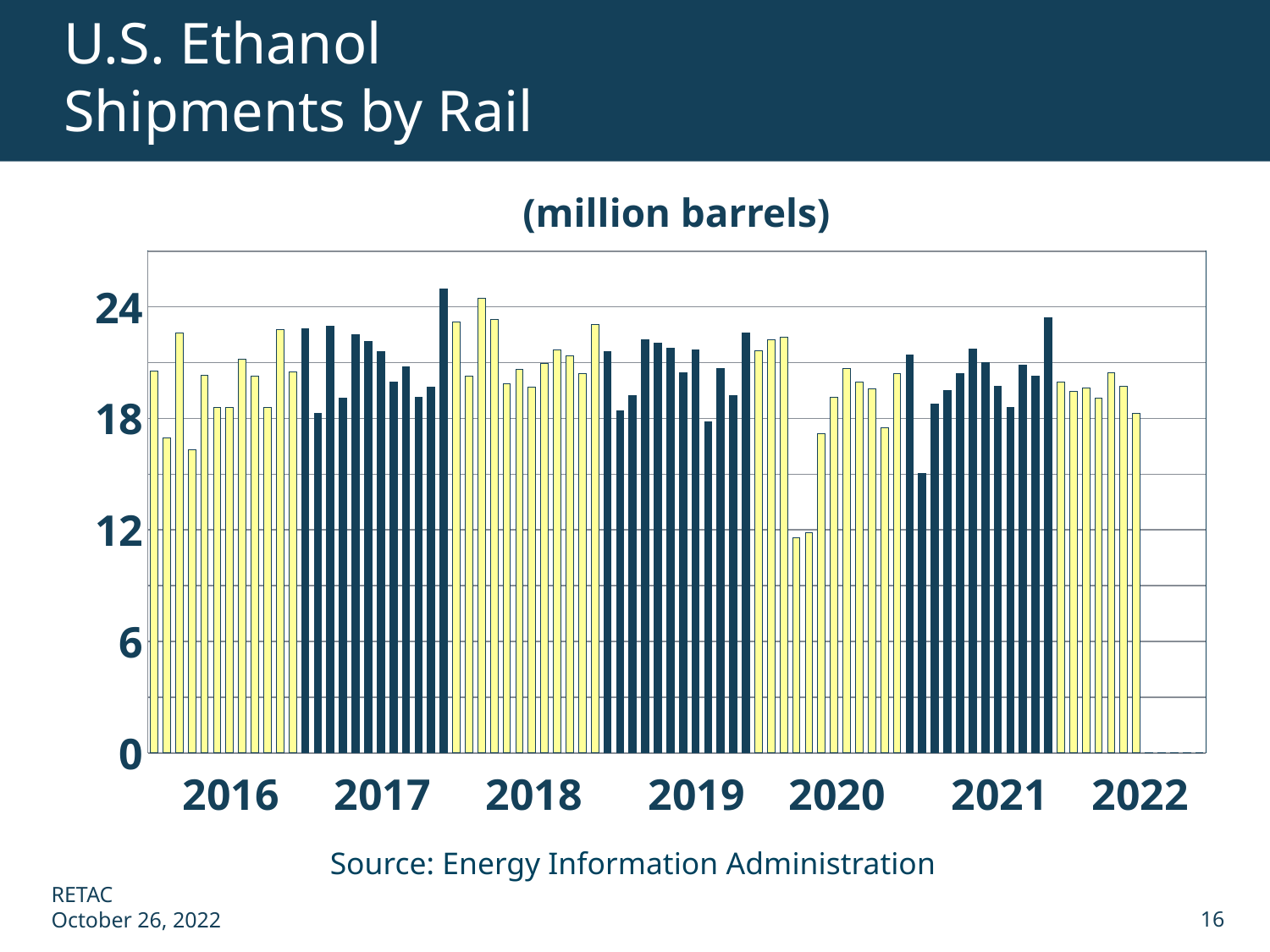
What source is cited below the chart? Energy Information Administration What is the highest tick value shown on the y axis? 24 Which year has the lower minimum monthly value, 2019 or 2020? 2020 What kind of chart is shown on the slide? bar chart Are the shortest bars in 2020 greater or less than 12? less How many year labels appear along the x axis of the chart? 7 Is the tallest bar in 2017 greater or less than 24? greater In which year does the tallest bar on the chart occur? 2017 Is the first bar of 2021 greater or less than 18? greater What unit is given in the chart's subtitle? million barrels In which year do the shortest bars on the chart occur? 2020